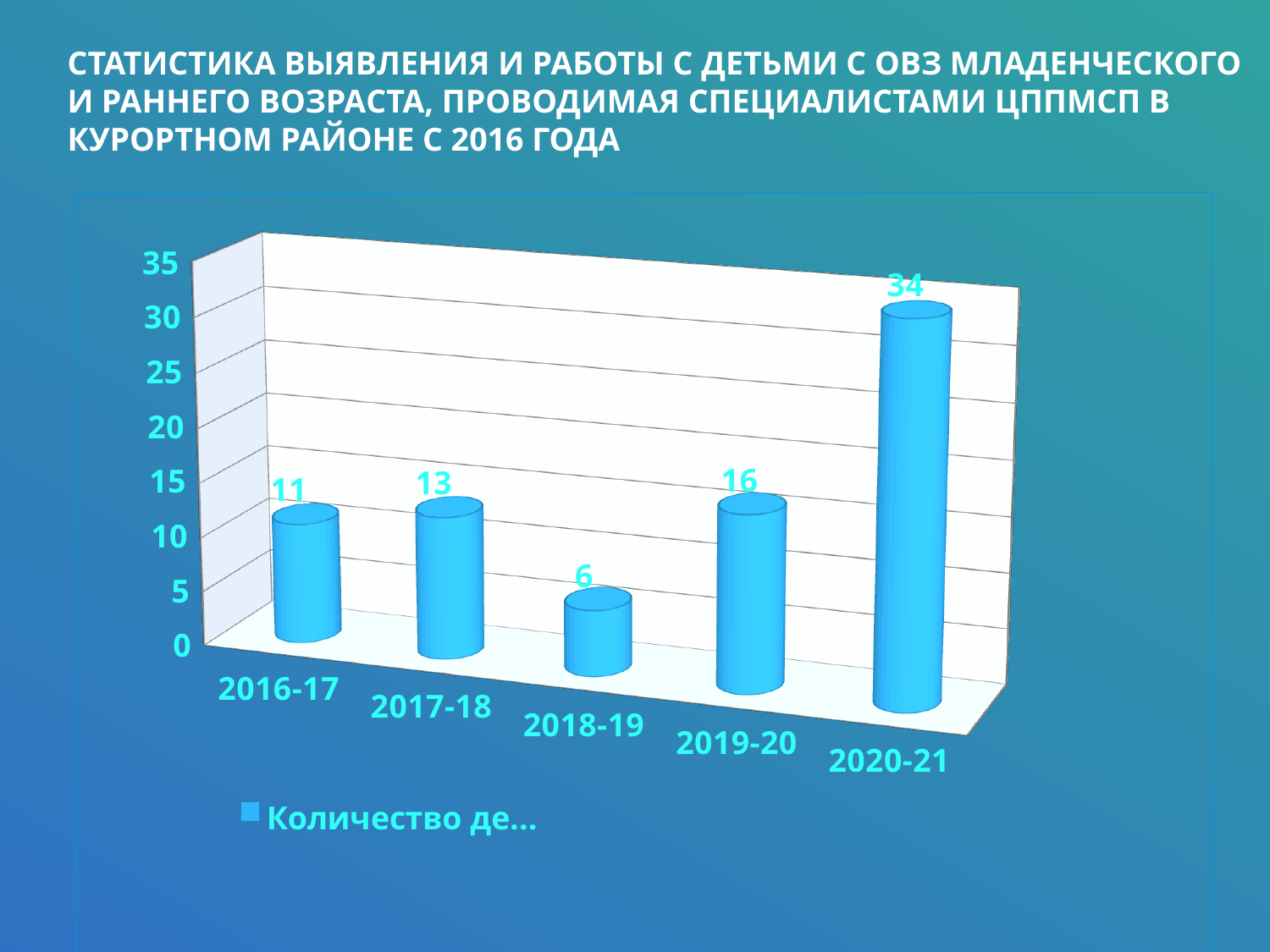
How many categories are shown on the x axis? 5 Which category has the highest value? 2020-21 What is the value for 2016-17? 11 What is the value for 2018-19? 6 Which is larger, the value for 2017-18 or the value for 2019-20? 2019-20 What is the difference between the values for 2020-21 and 2019-20? 18 What is the difference between the values for 2017-18 and 2016-17? 2 What is the value for 2020-21? 34 What kind of chart is shown on the slide? bar chart Which category has the lowest value? 2018-19 Is the value for 2020-21 greater or less than 30? greater How many series does the legend list? 1